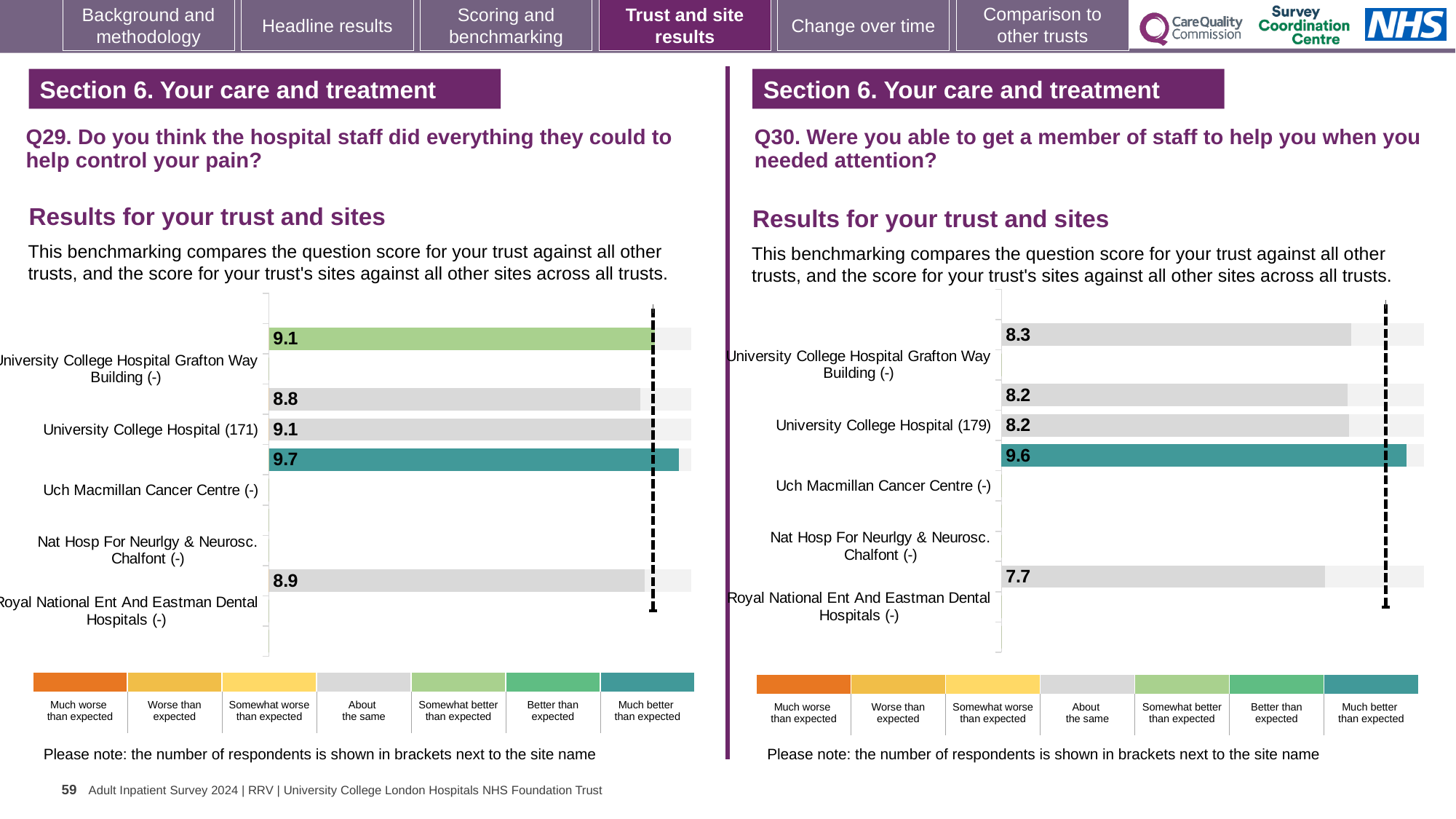
On the Q30 chart (right), what is the highest score shown on any bar? 9.6 On the Q30 chart (right), what is the lowest score shown on any bar? 7.7 On the Q29 chart (left), how many site names are listed on the vertical axis? 5 On the Q29 chart (left), what kind of chart is used to show the scores? bar chart On the Q30 chart (right), what is the difference between the highest score (9.6) and the lowest score (7.7)? 1.9 On the Q29 chart (left), how many respondents are shown in brackets next to University College Hospital? 171 On the Q30 chart (right), how many respondents are shown in brackets next to University College Hospital? 179 Which is larger: the lowest score on the Q29 chart (8.8) or the lowest score on the Q30 chart (7.7)? Q29 (8.8) On the Q29 chart (left), what is the difference between the highest score (9.7) and the lowest score (8.8)? 0.9 On the Q29 chart (left), what is the lowest score shown on any bar? 8.8 How many categories does the colour key below each chart list? 7 On the Q29 chart (left), what is the highest score shown on any bar? 9.7